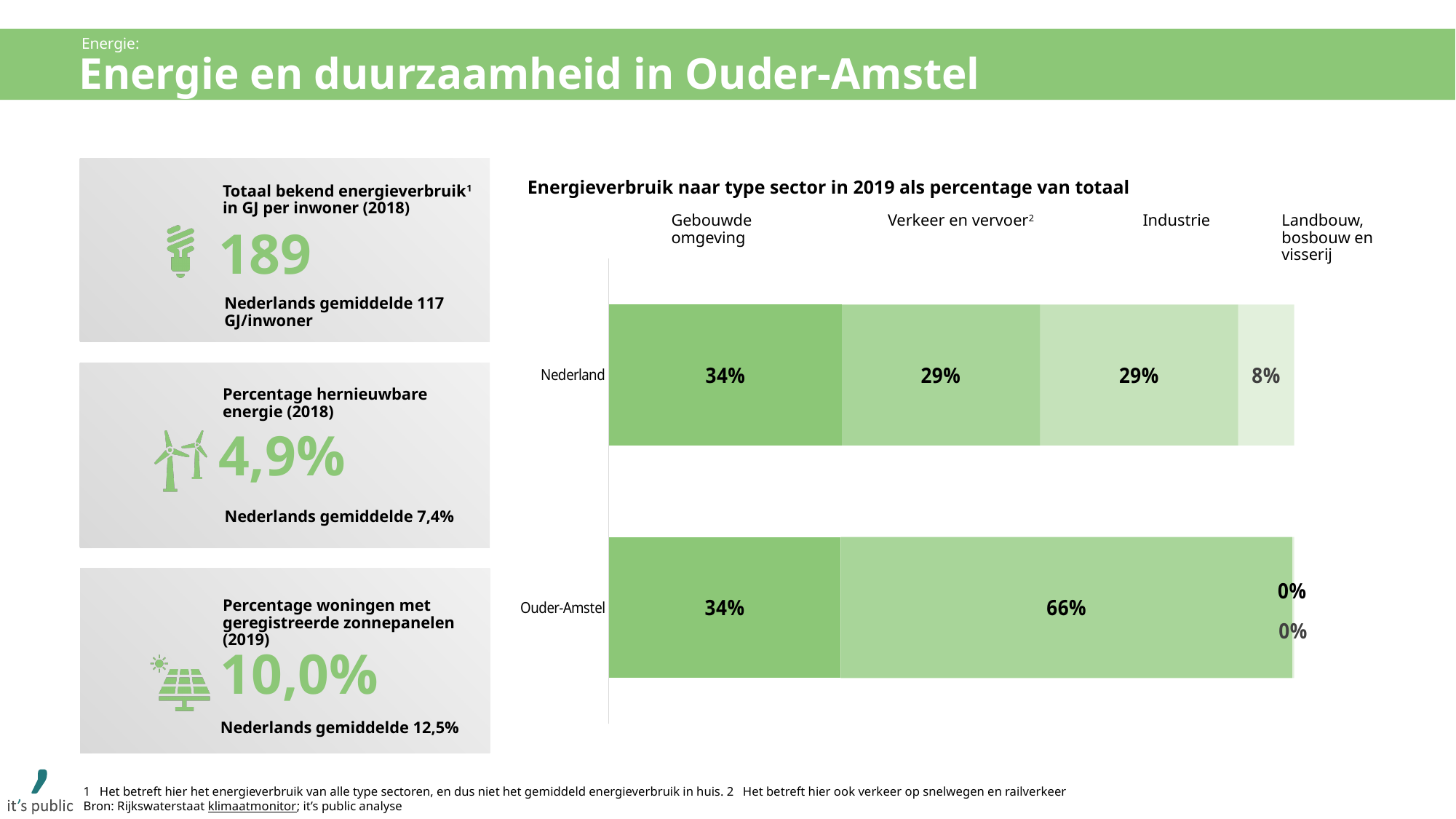
What is the value for Gebouwde omgeving for Ouder-Amstel? 34% Which is larger: the Industrie share for Nederland or for Ouder-Amstel? Nederland Which sector has the highest share for Ouder-Amstel? Verkeer en vervoer What is the value for Verkeer en vervoer for Ouder-Amstel? 66% What is the value for Industrie for Ouder-Amstel? 0% What is the value for Verkeer en vervoer for Nederland? 29% How many regions (bars) are shown in the chart? 2 What is the difference between the Verkeer en vervoer share for Ouder-Amstel and for Nederland? 37 percentage points How many sectors (series) does the chart show? 4 What is the value for Landbouw, bosbouw en visserij for Nederland? 8% What kind of chart is shown on the slide? Stacked bar chart Which sector has the lowest share for Nederland? Landbouw, bosbouw en visserij